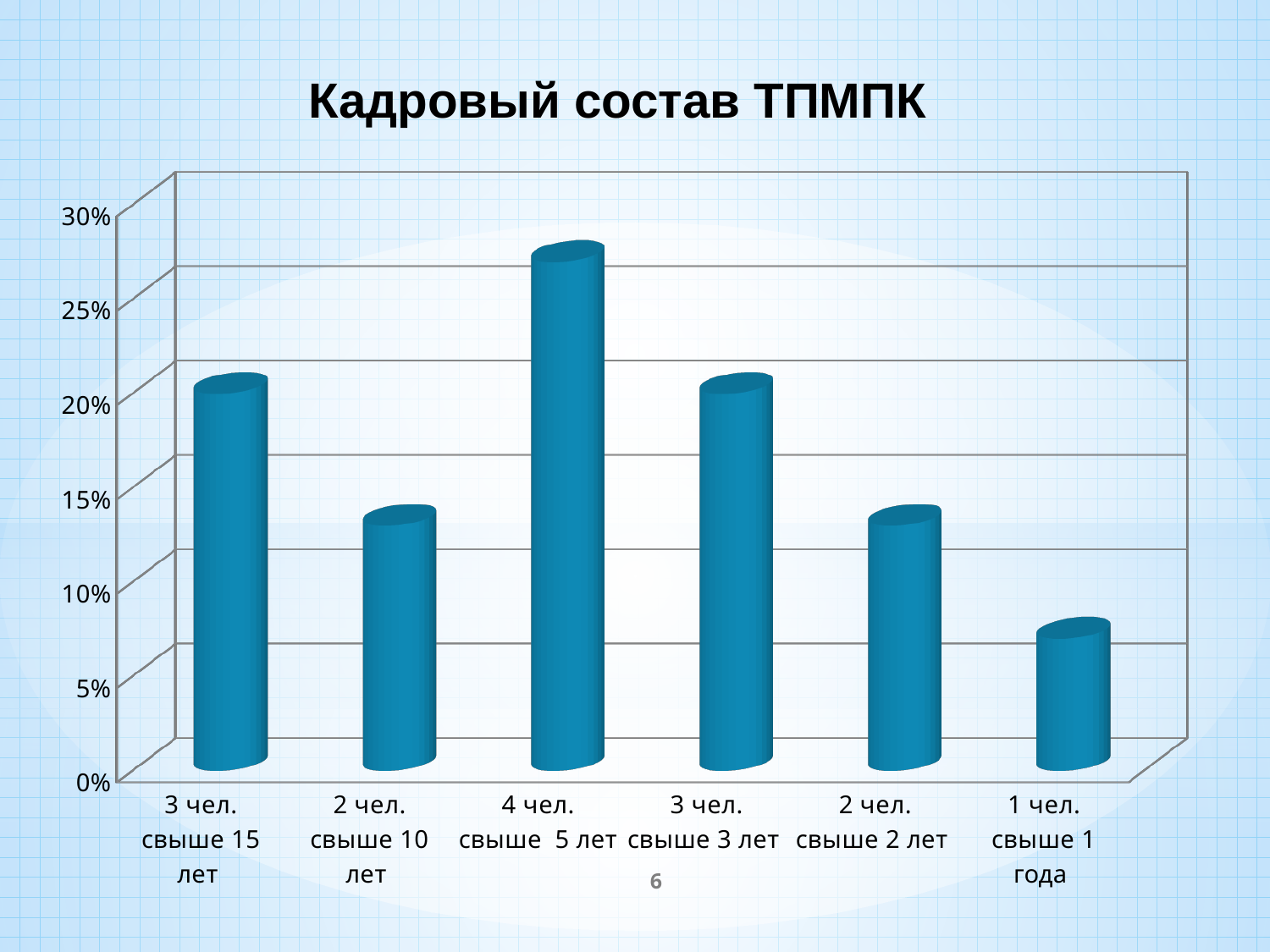
Is the value for "3 чел. свыше 3 лет" greater or less than 15%? greater Which is larger, the value for "3 чел. свыше 15 лет" or the value for "2 чел. свыше 10 лет"? 3 чел. свыше 15 лет Which category has the lowest value? 1 чел. свыше 1 года What kind of chart is shown on the slide? bar chart How many categories are shown on the x axis of the chart? 6 Do the values rise or fall from "4 чел. свыше 5 лет" to "1 чел. свыше 1 года" along the x axis? fall Which is larger, the value for "2 чел. свыше 2 лет" or the value for "1 чел. свыше 1 года"? 2 чел. свыше 2 лет Is the value for "2 чел. свыше 10 лет" greater or less than 15%? less What is the title of the chart? Кадровый состав ТПМПК Is the value for "4 чел. свыше 5 лет" greater or less than 25%? greater Which category has the highest value? 4 чел. свыше 5 лет